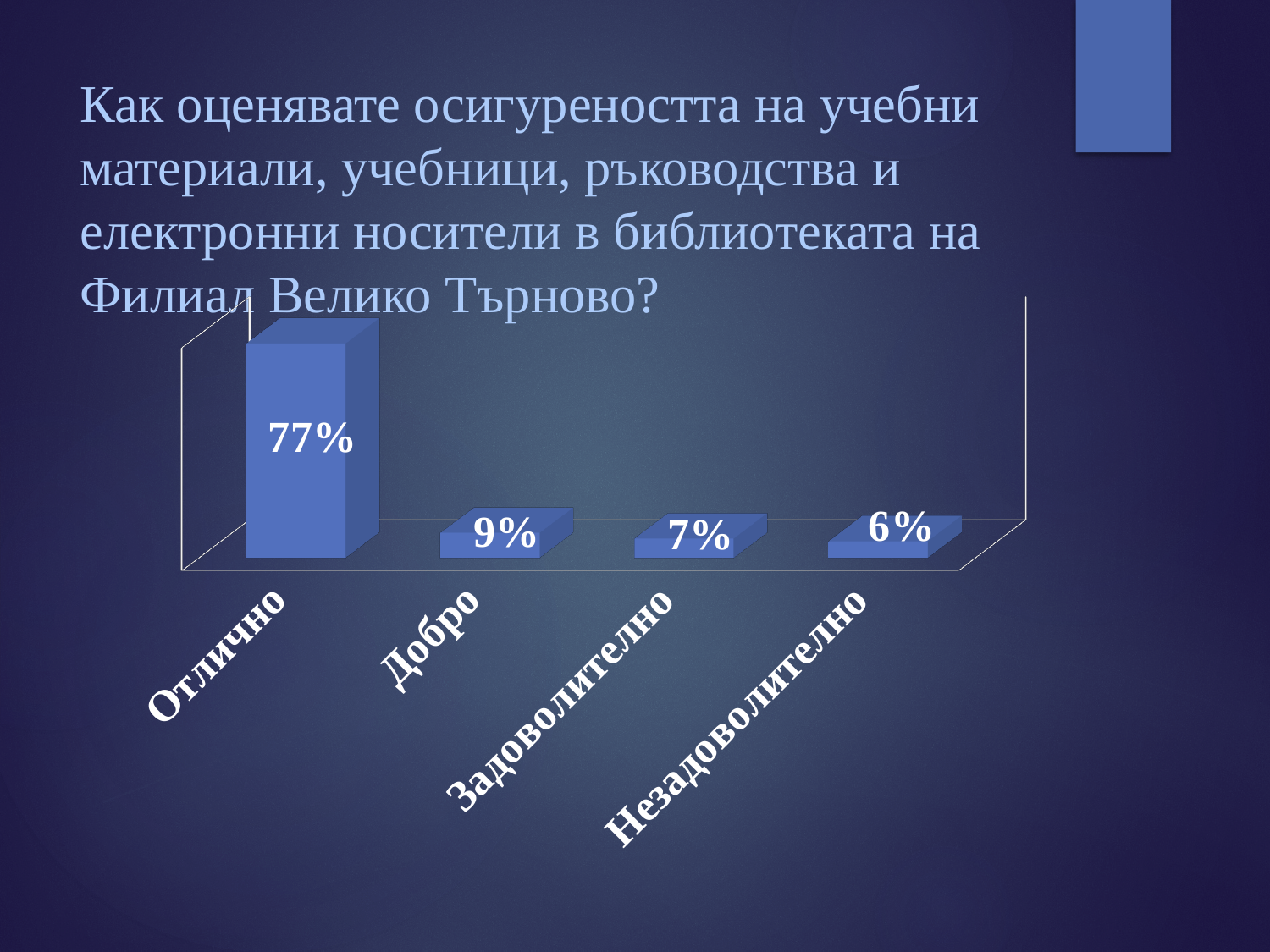
What is the difference between the values for Отлично and Добро? 68% Which category has the lowest value? Незадоволително Which category has the highest value? Отлично What is the value for Задоволително? 7% Do the values rise or fall from left to right across the categories? Fall What is the value for Незадоволително? 6% What is the value for Добро? 9% How many categories are shown in the chart? 4 Which is larger, the value for Добро or the value for Задоволително? Добро What kind of chart is shown on the slide? Bar chart What is the value for Отлично? 77% What is the difference between the values for Добро and Незадоволително? 3%